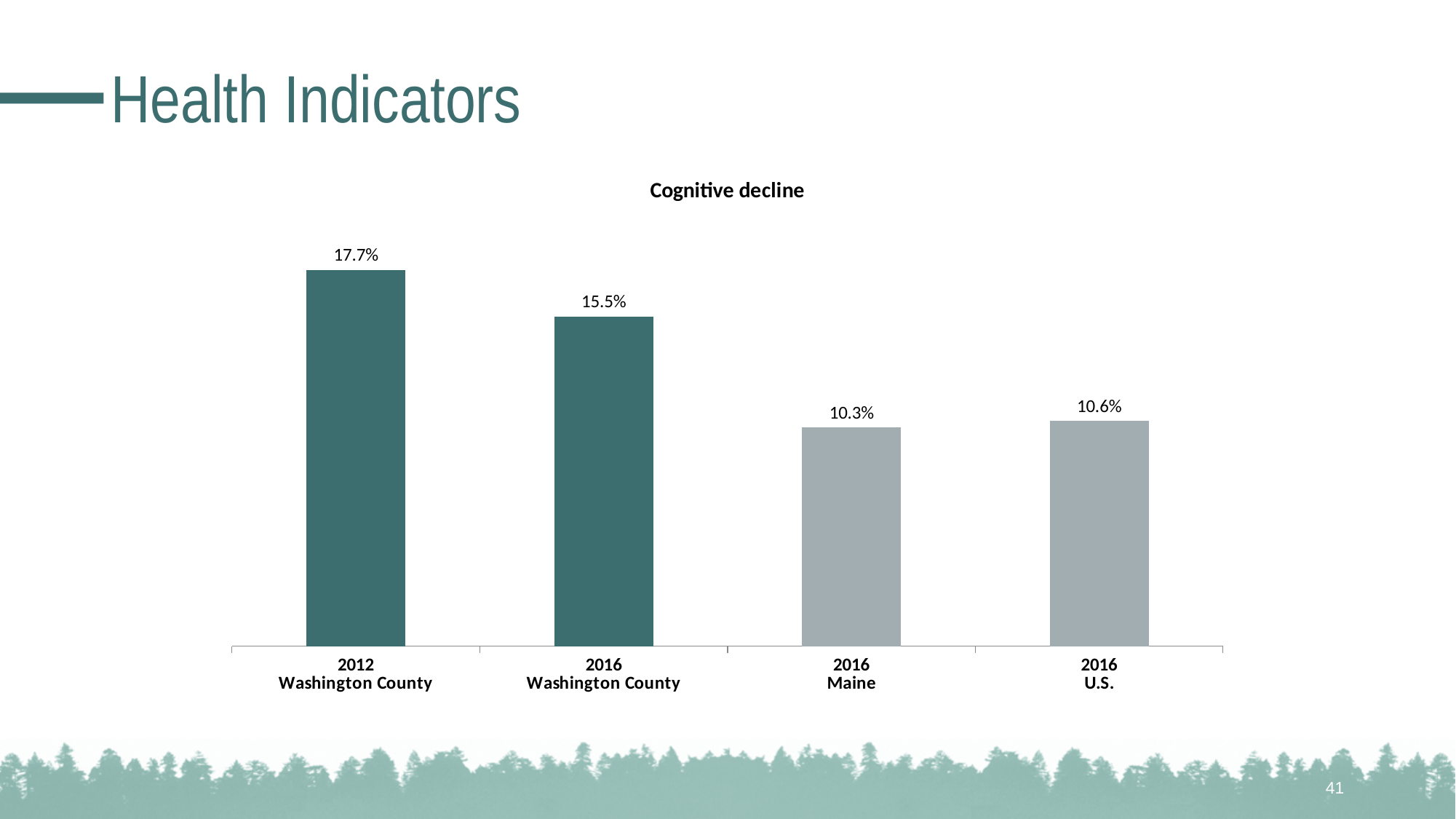
What is the title of the chart on the slide? Cognitive decline Which is larger in the Cognitive decline chart: 2016 Washington County or 2016 Maine? 2016 Washington County What is the difference between the 2016 Washington County value and the 2016 U.S. value in the Cognitive decline chart? 4.9% What is the difference between the 2012 and 2016 Washington County values in the Cognitive decline chart? 2.2% What is the value for 2016 Washington County in the Cognitive decline chart? 15.5% Which category has the highest value in the Cognitive decline chart? 2012 Washington County How many bars are shown in the Cognitive decline chart? 4 What is the value for 2012 Washington County in the Cognitive decline chart? 17.7% Which category has the lowest value in the Cognitive decline chart? 2016 Maine What kind of chart is shown on the slide? Bar chart What is the value for 2016 Maine in the Cognitive decline chart? 10.3% What is the value for 2016 U.S. in the Cognitive decline chart? 10.6%